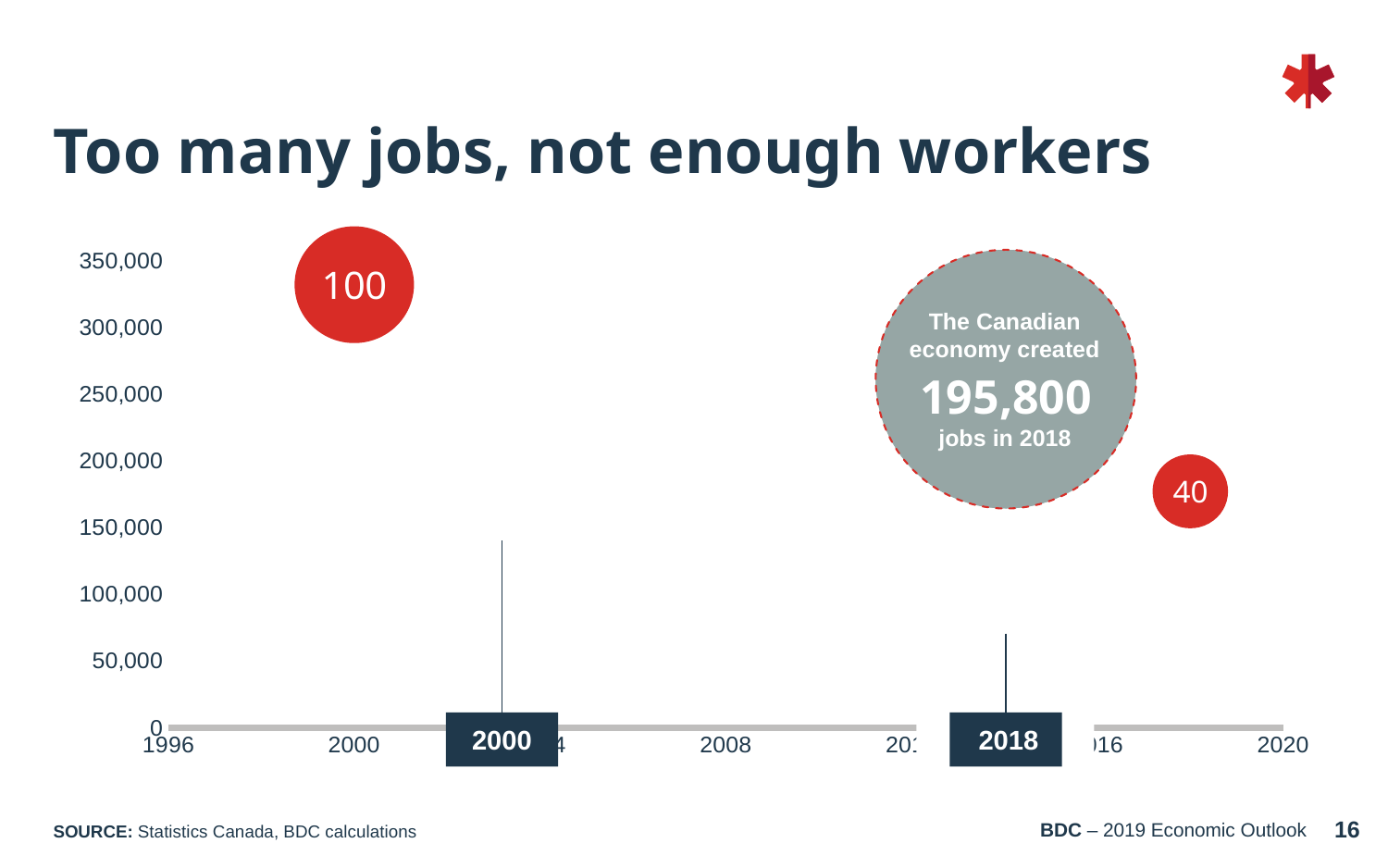
What is the highest value shown on the y axis? 350,000 What kind of chart is shown on the slide? bubble chart Is the bubble at 2018 plotted greater or less than 150,000 on the y axis? greater Do the plotted values rise or fall from 2000 to 2018? fall What label is shown on the bubble plotted at 2000? 100 What label is shown on the bubble plotted at 2018? 40 Is the bubble at 2018 plotted greater or less than 250,000 on the y axis? less Is the bubble at 2000 plotted greater or less than 300,000 on the y axis? greater How many bubbles are plotted on the chart? 2 According to the annotation on the chart, how many jobs did the Canadian economy create in 2018? 195,800 Which bubble is plotted higher on the y axis, the one at 2000 or the one at 2018? 2000